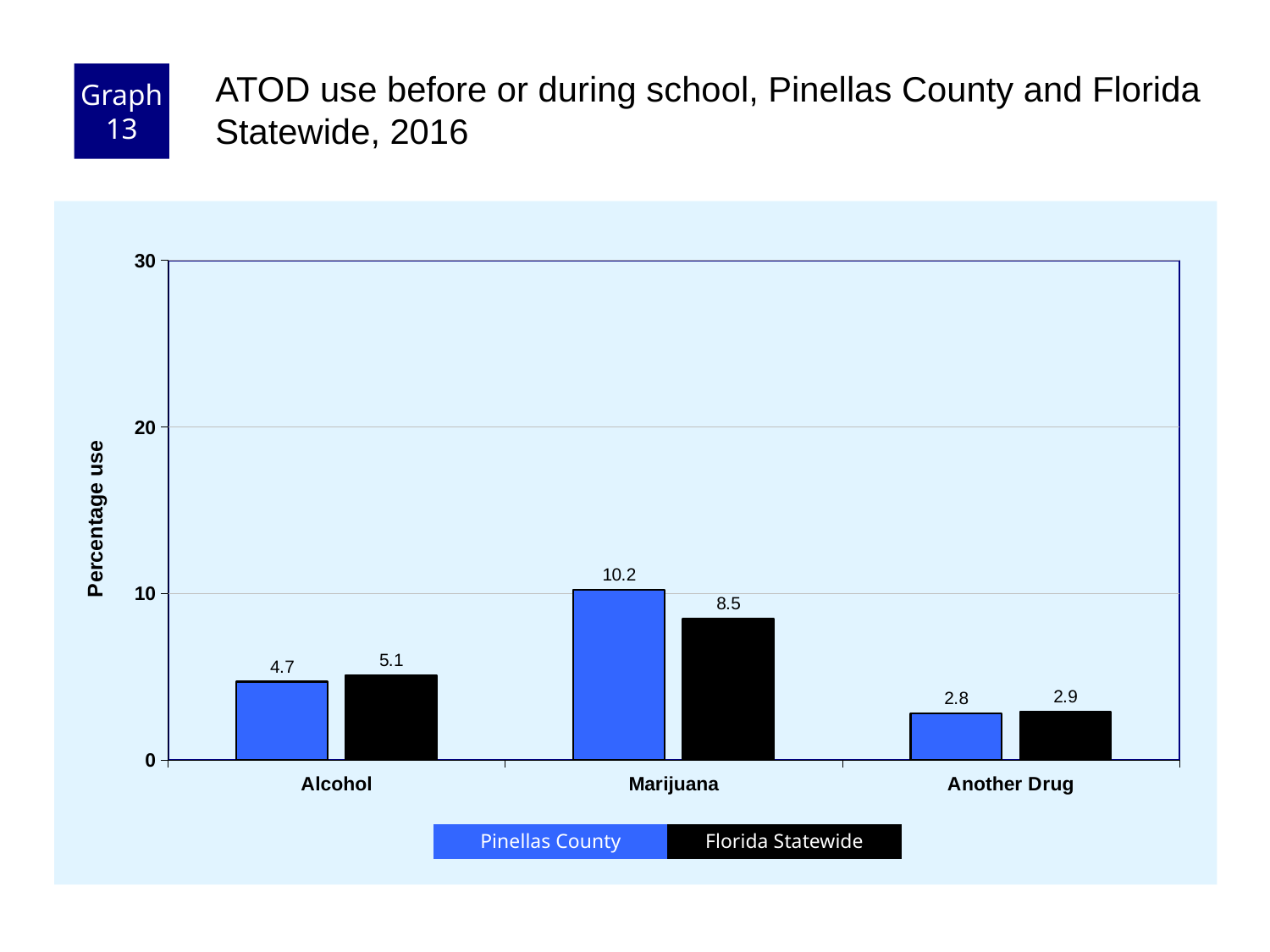
For Alcohol, which is larger: Pinellas County or Florida Statewide? Florida Statewide How many series does the legend list? 2 Which category has the lowest Florida Statewide value? Another Drug How many categories are shown on the x axis? 3 What kind of chart is shown on the slide? bar chart What is the Pinellas County value for Marijuana? 10.2 What is the Pinellas County value for Another Drug? 2.8 What is the Florida Statewide value for Alcohol? 5.1 Which category has the highest Pinellas County value? Marijuana Is the Pinellas County value for Marijuana greater or less than 10? greater What is the difference between the Pinellas County and Florida Statewide values for Marijuana? 1.7 What is the difference between the Florida Statewide values for Alcohol and Another Drug? 2.2